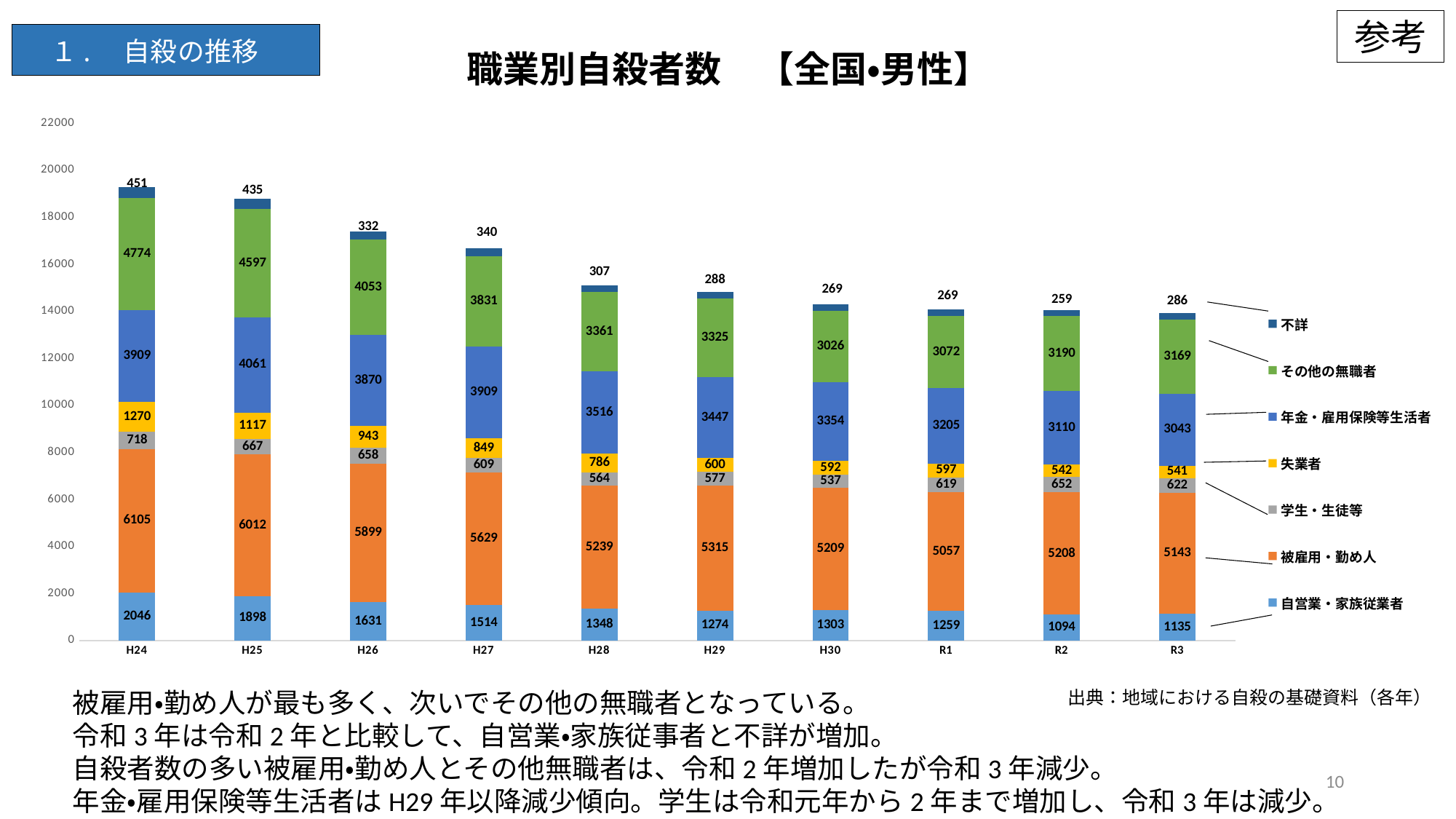
How many years (categories) are shown on the x axis? 10 Which is larger, the 失業者 value in H28 or in H29? H28 In which year is the value for 不詳 highest? H24 What is the difference between the 被雇用・勤め人 values in H24 and R3? 962 What is the value for 不詳 in R3? 286 In which year is the value for 自営業・家族従業者 lowest? R2 What is the value for 年金・雇用保険等生活者 in H26? 3870 How many series does the legend list? 7 What is the total of the stacked bar for R3? 13939 Do the values for 年金・雇用保険等生活者 rise or fall from H29 to R3? Fall What is the value for 被雇用・勤め人 in H24? 6105 What kind of chart is shown on the slide? Stacked bar chart